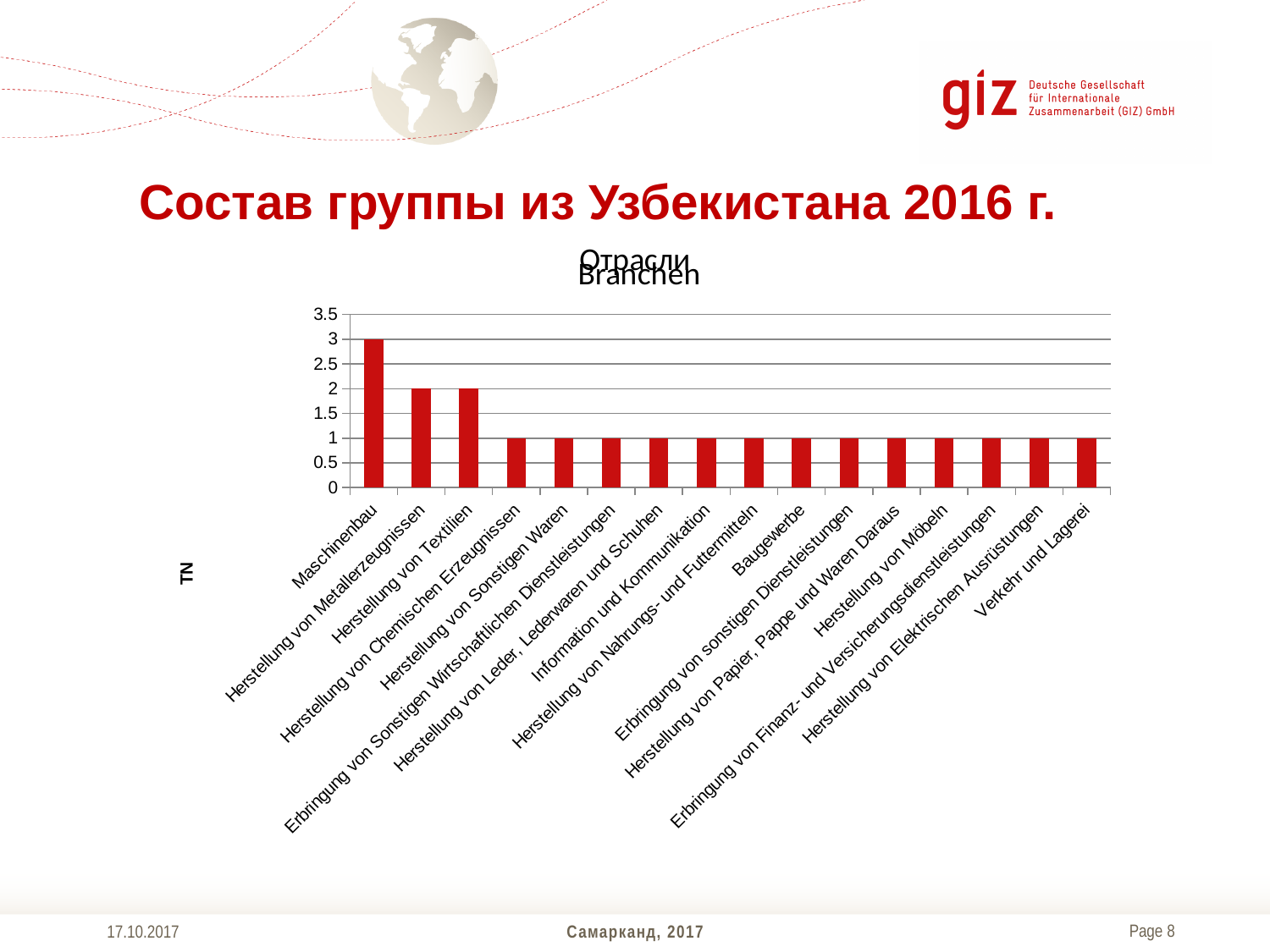
How many categories are shown on the x axis? 16 Which is larger, the value for Herstellung von Metallerzeugnissen or the value for Information und Kommunikation? Herstellung von Metallerzeugnissen What is the label on the vertical axis? TN What is the value for Verkehr und Lagerei? 1 What is the value for Herstellung von Textilien? 2 Which category has the highest value? Maschinenbau What is the value for Herstellung von Möbeln? 1 What is the value for Maschinenbau? 3 Is the value for Maschinenbau greater or less than 2.5? greater What type of chart is shown on the slide? bar chart What is the value for Baugewerbe? 1 What is the difference between the values for Maschinenbau and Herstellung von Metallerzeugnissen? 1